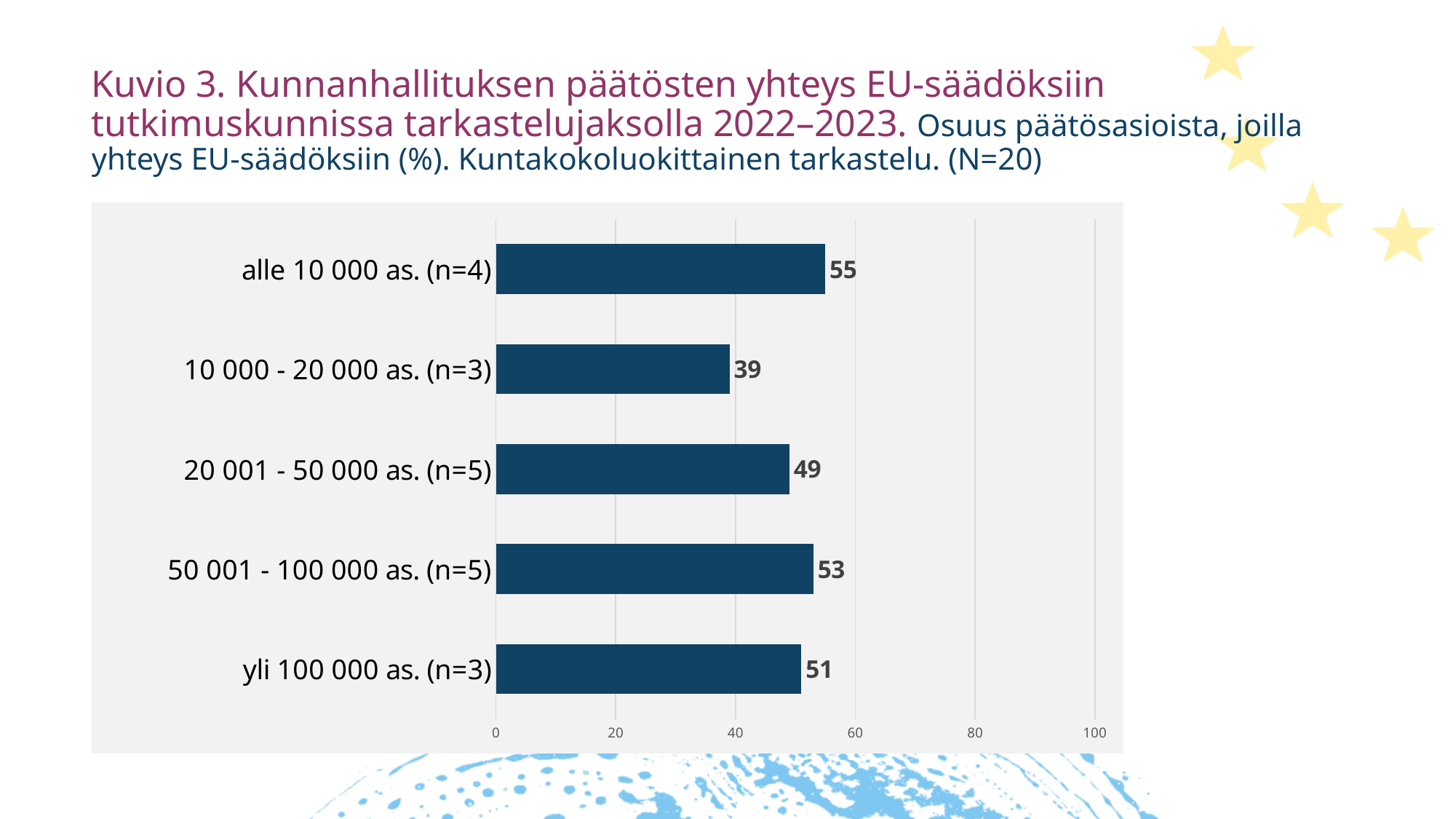
Which category has the lowest value? 10 000 - 20 000 as. (n=3) What is the value for '50 001 - 100 000 as. (n=5)'? 53 What is the highest tick value shown on the horizontal axis? 100 What kind of chart is shown on the slide? bar chart What is the value for '20 001 - 50 000 as. (n=5)'? 49 What is the value for '10 000 - 20 000 as. (n=3)'? 39 Which category has the highest value? alle 10 000 as. (n=4) What is the value for 'yli 100 000 as. (n=3)'? 51 What is the value for 'alle 10 000 as. (n=4)'? 55 How many categories are shown in the chart? 5 Which is larger, the value for '50 001 - 100 000 as. (n=5)' or the value for 'yli 100 000 as. (n=3)'? 50 001 - 100 000 as. (n=5) What is the difference between the values for 'alle 10 000 as. (n=4)' and '10 000 - 20 000 as. (n=3)'? 16